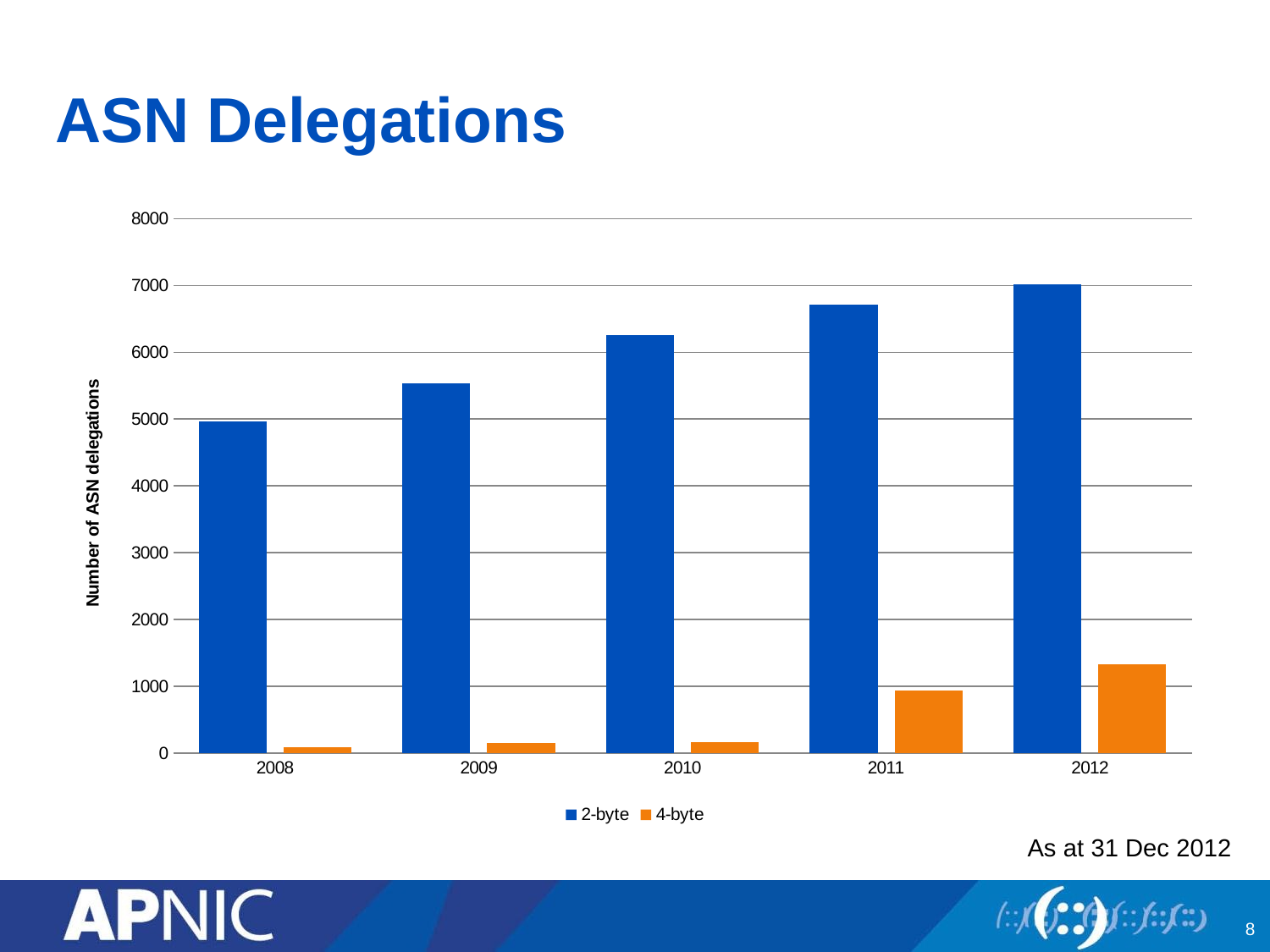
Do the 2-byte values rise or fall from 2008 to 2012? rise What is the title of the y axis? Number of ASN delegations How many years are shown on the x axis? 5 In which year is the 4-byte value highest? 2012 Is the 2-byte value for 2010 greater or less than 6000? greater How many series does the legend list? 2 Is the 2-byte value for 2009 greater or less than 5000? greater Which is larger in 2011, the 2-byte value or the 4-byte value? 2-byte Is the 4-byte value for 2012 greater or less than 1000? greater In which year is the 2-byte value lowest? 2008 In which year is the 2-byte value highest? 2012 What kind of chart is shown on the slide? bar chart